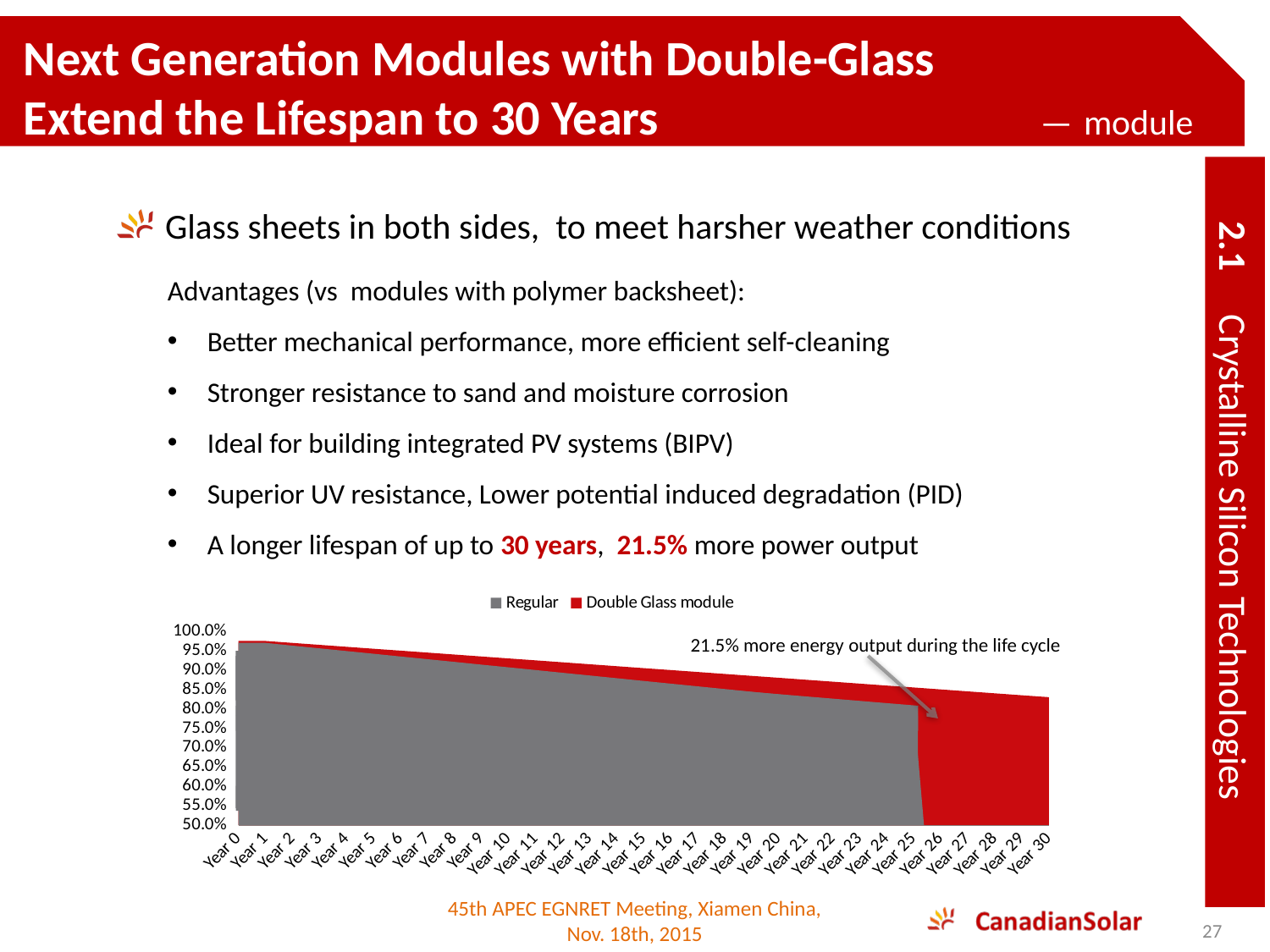
What is the first category on the x axis of the chart? Year 0 At which year does the Double Glass module series reach its highest value? Year 0 Which is larger for the Regular series: the value at Year 0 or the value at Year 20? Year 0 Is the value for the Regular series at Year 0 greater or less than 90.0%? greater What kind of chart is shown on the slide? Area chart What is the lowest value shown on the chart's y axis? 50.0% Is the value for the Regular series at Year 20 greater or less than 75.0%? greater What are the two series named in the chart legend? Regular and Double Glass module Is the value for the Double Glass module series at Year 30 greater or less than 90.0%? less Do the plotted values rise or fall from Year 0 to Year 30? Fall How many series does the chart legend list? 2 How many year categories are shown on the x axis of the chart? 31